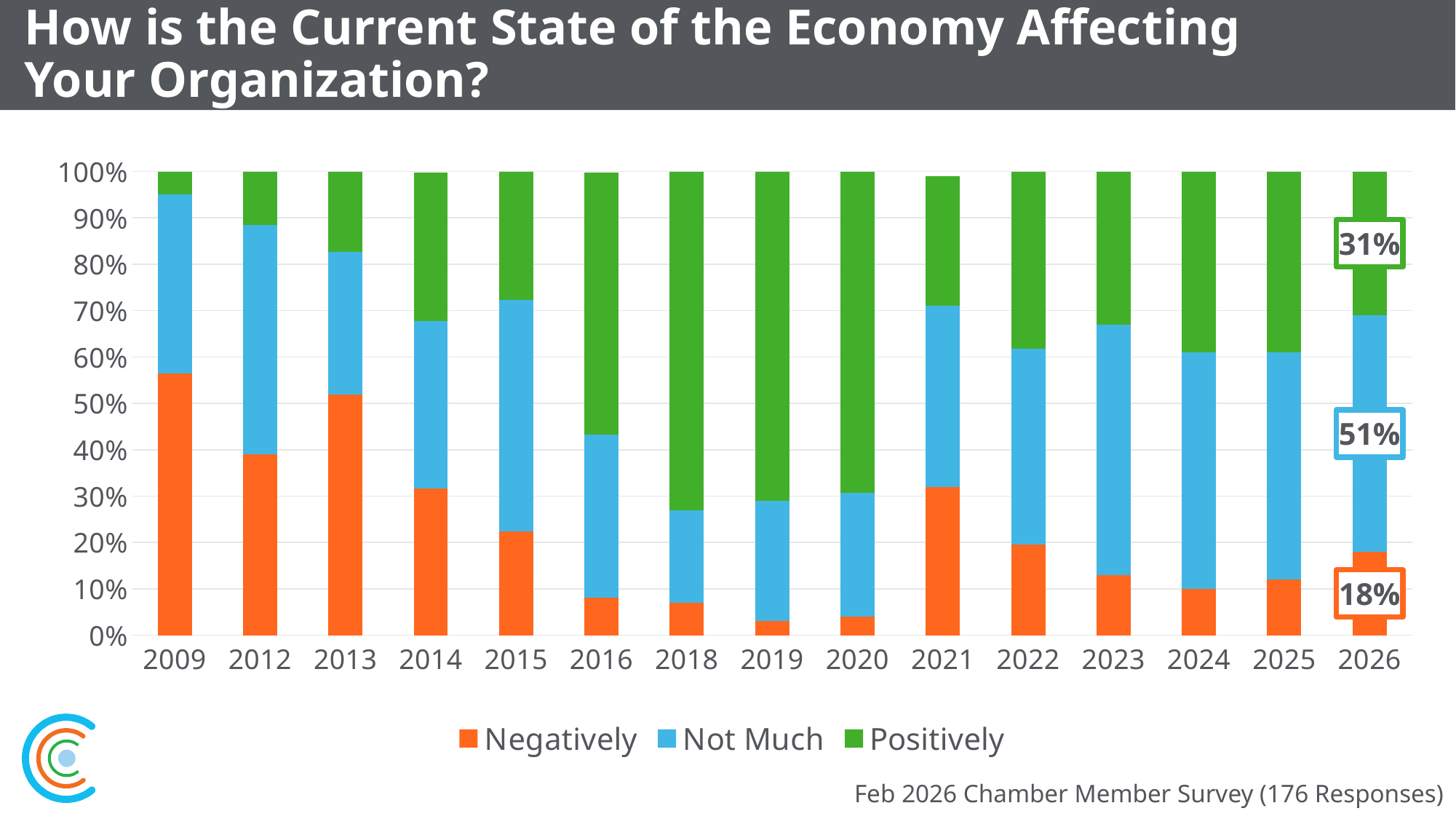
Is the Negatively value for 2019 greater or less than 10%? less What kind of chart is shown on the slide? Stacked bar chart Which year has the larger Negatively share, 2009 or 2021? 2009 What percentage of respondents in 2026 said the economy is affecting their organization Negatively? 18% How many series does the legend list? 3 What is the difference between the Not Much and Negatively shares in 2026? 33% What is the total of the three segments in the 2026 bar? 100% What is the Not Much share for 2026? 51% From 2009 to 2019, does the Negatively share generally rise or fall? fall What is the Positively share for 2026? 31% How many years are shown on the x axis? 15 Is the Negatively value for 2009 greater or less than 50%? greater